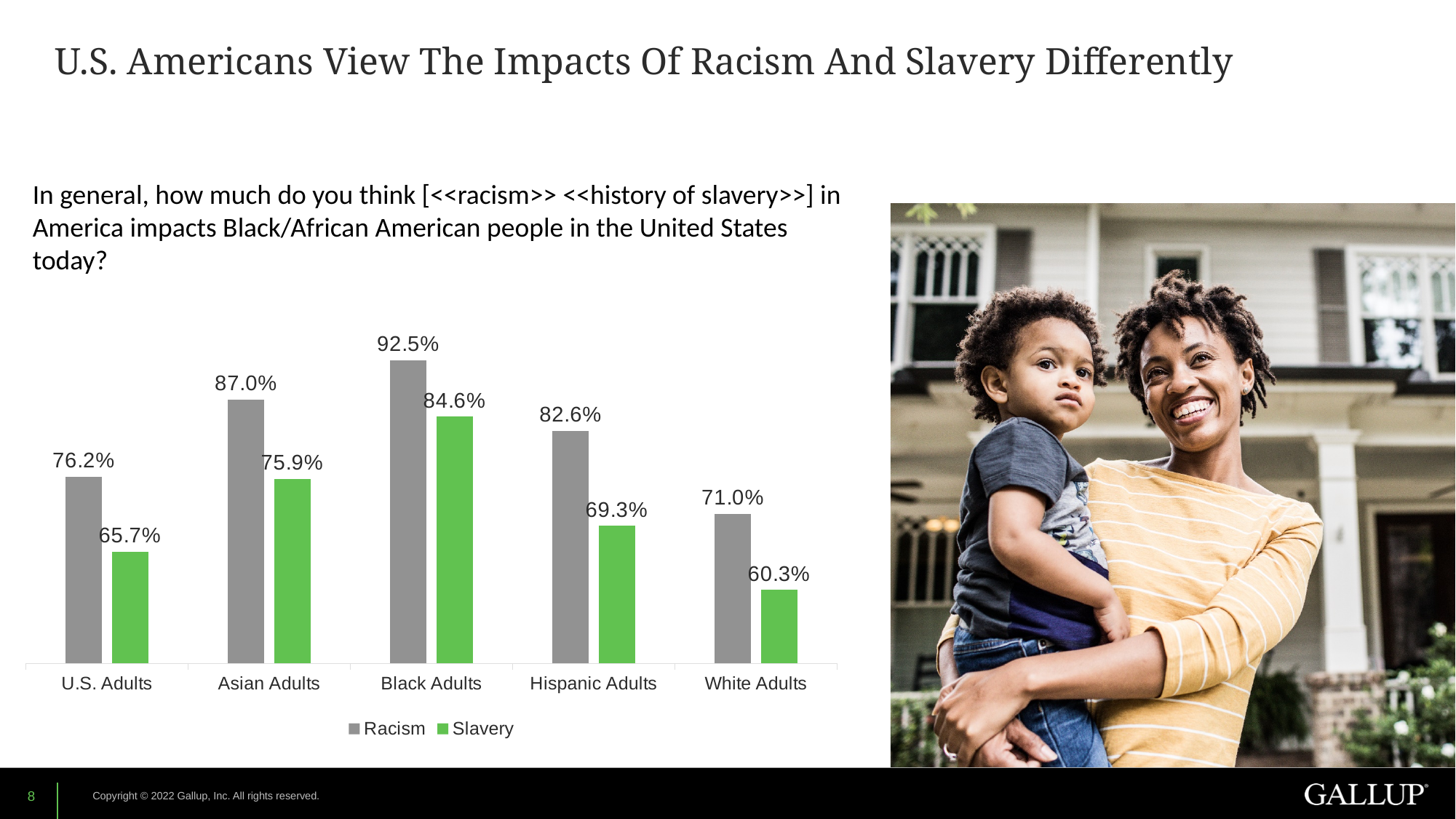
What is the difference between the Racism and Slavery values for Hispanic Adults? 13.3% What kind of chart is shown on the slide? Bar chart Which category has the lowest Slavery value? White Adults How many categories are shown on the x axis of the chart? 5 What is the Racism value for Black Adults? 92.5% Which category has the highest Racism value? Black Adults Which colour represents the Slavery series in the chart? Green What is the Slavery value for White Adults? 60.3% Which is larger, the Slavery value for U.S. Adults or the Slavery value for Hispanic Adults? Hispanic Adults How many series does the legend list? 2 What is the Slavery value for Asian Adults? 75.9% What is the difference between the Racism values for Black Adults and White Adults? 21.5%